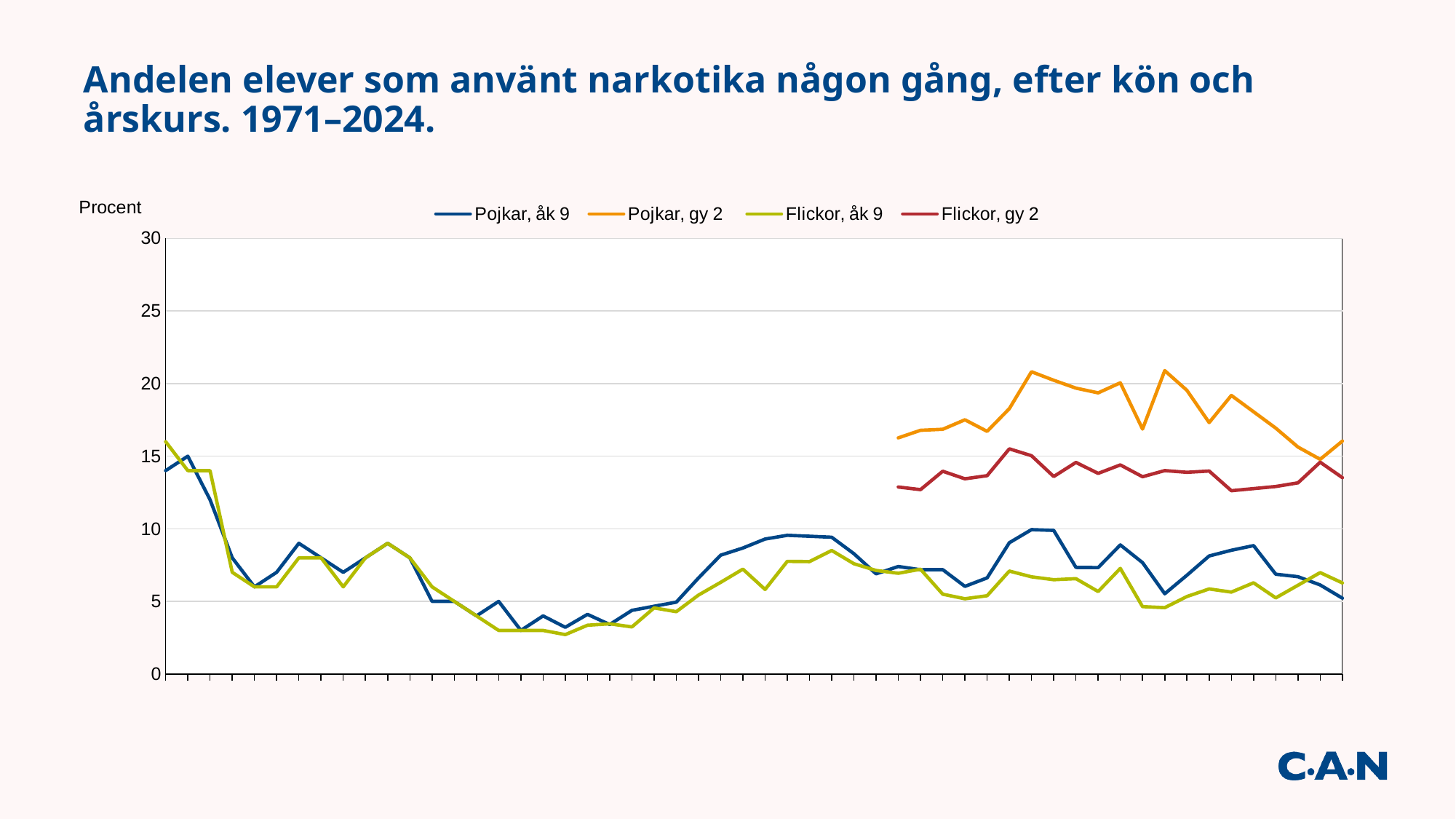
What kind of chart is shown on the slide? line chart Is the value for Flickor, gy 2 at the right end of the chart greater or less than 15? less Is the lowest value of the Flickor, åk 9 line greater or less than 5? less At the left end of the chart, is the value for Pojkar, åk 9 greater or less than 10? greater At the right end of the chart, which line is higher, Pojkar, åk 9 or Flickor, åk 9? Flickor, åk 9 Which series reaches the highest value on the chart? Pojkar, gy 2 What is the title of the chart? Andelen elever som använt narkotika någon gång, efter kön och årskurs. 1971–2024. What label is shown on the vertical axis? Procent How many series does the legend list? 4 Which series reaches higher values, Pojkar, gy 2 or Flickor, gy 2? Pojkar, gy 2